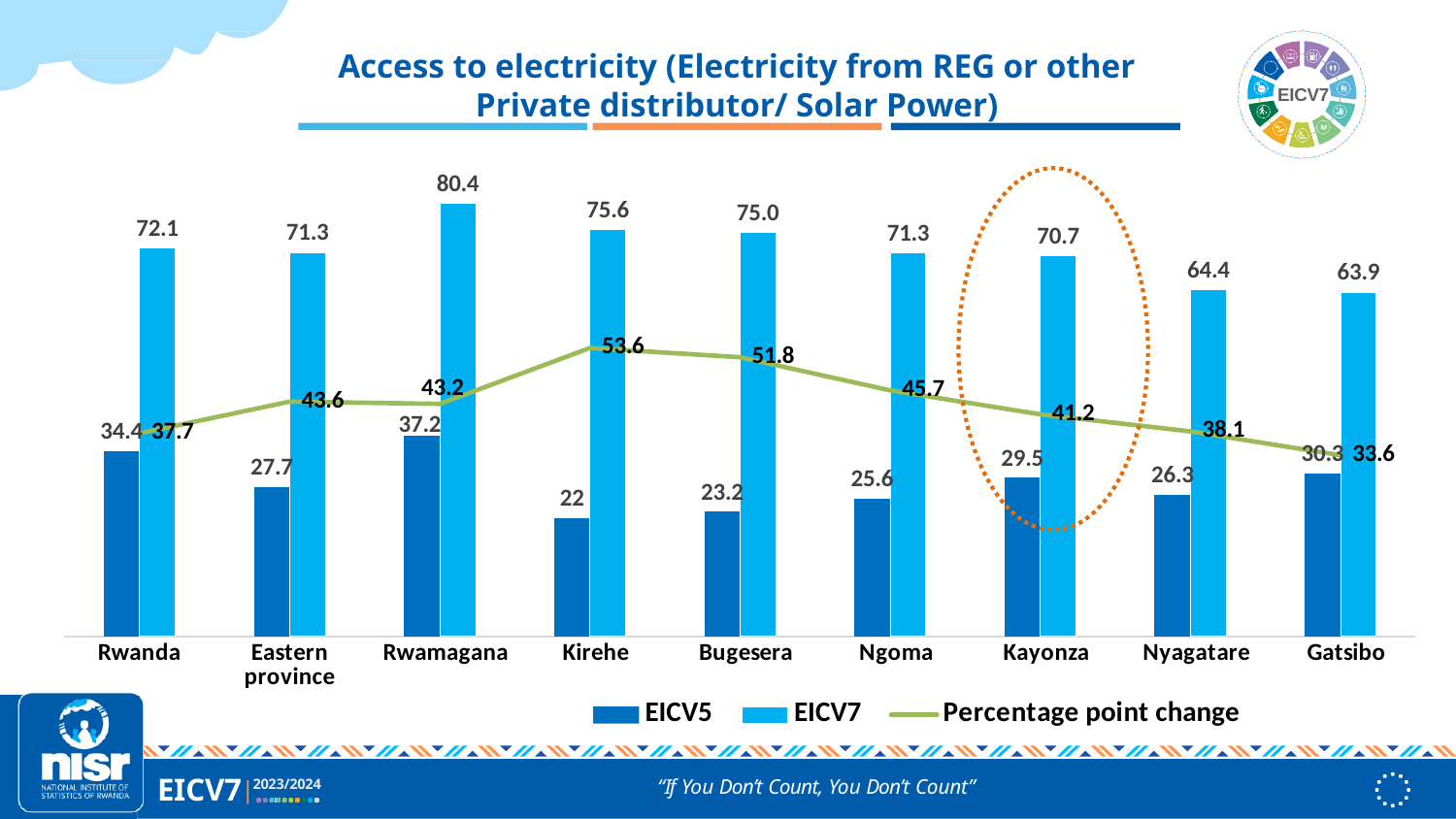
Which category has the highest EICV7 value? Rwamagana What is the EICV7 value for Rwamagana? 80.4 How many categories are shown on the x axis? 9 What is the EICV5 value for Kirehe? 22 Which category has the lowest EICV5 value? Kirehe Which category is highlighted with a dotted orange oval? Kayonza What is the Percentage point change for Kayonza? 41.2 Which is larger, the EICV7 value for Nyagatare or the EICV7 value for Gatsibo? Nyagatare How many series does the legend list? 3 What is the difference between the EICV7 and EICV5 values for Rwanda? 37.7 What kind of chart is this? Combined bar and line chart Which category has the highest Percentage point change? Kirehe